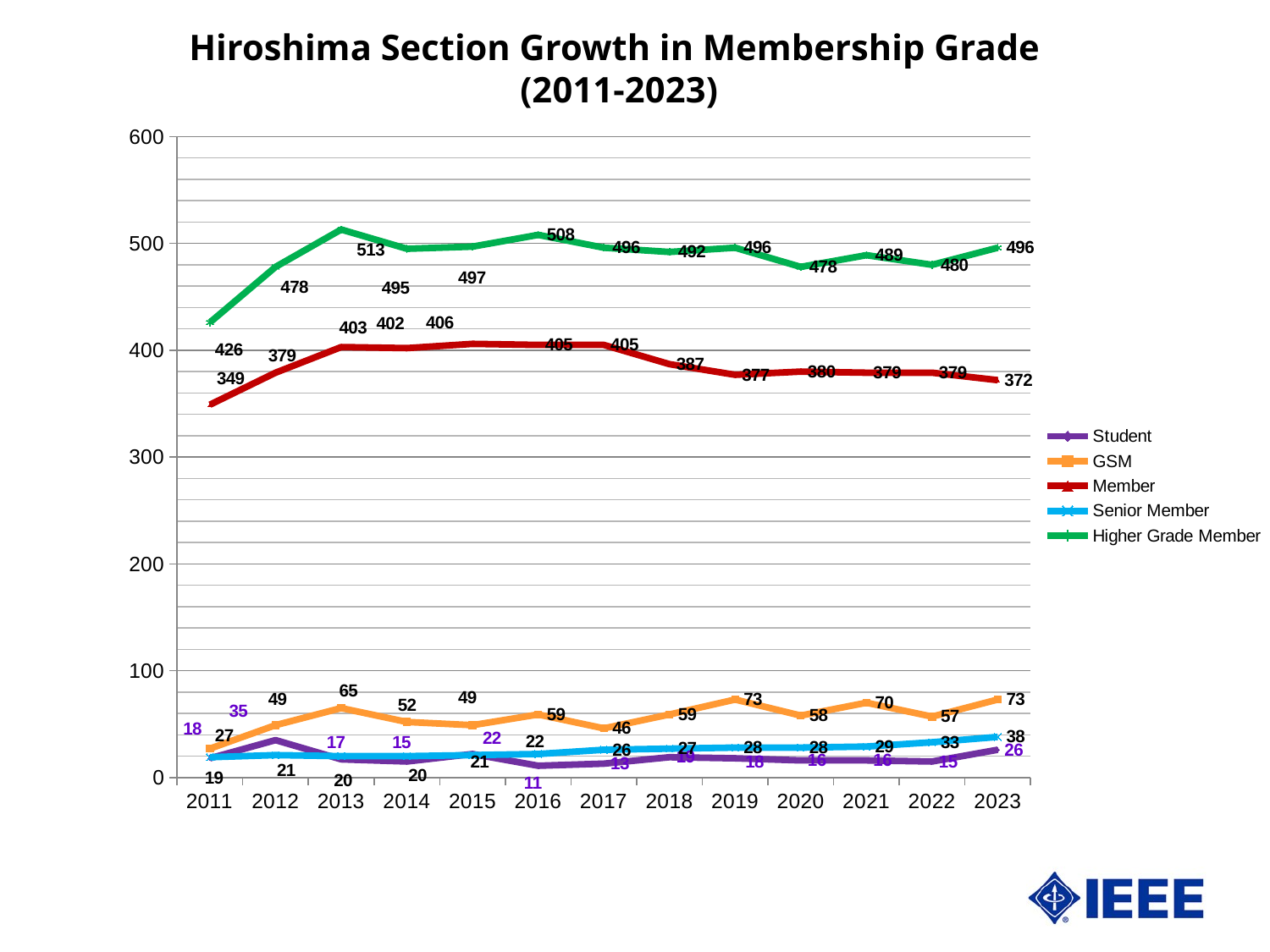
How many series does the legend list? 5 In which year is the Higher Grade Member series at its highest? 2013 What is the Member value in 2023? 372 In which year is the Member series at its lowest? 2011 Does the Senior Member series rise or fall from 2011 to 2023? rise What is the Higher Grade Member value in 2013? 513 What kind of chart is shown on the slide? line chart How many years are plotted along the x axis? 13 What is the title of the chart? Hiroshima Section Growth in Membership Grade (2011-2023) Which is larger, the GSM value in 2013 or in 2019? 2019 What is the Senior Member value in 2023? 38 What is the difference between the Member values in 2023 and 2011? 23